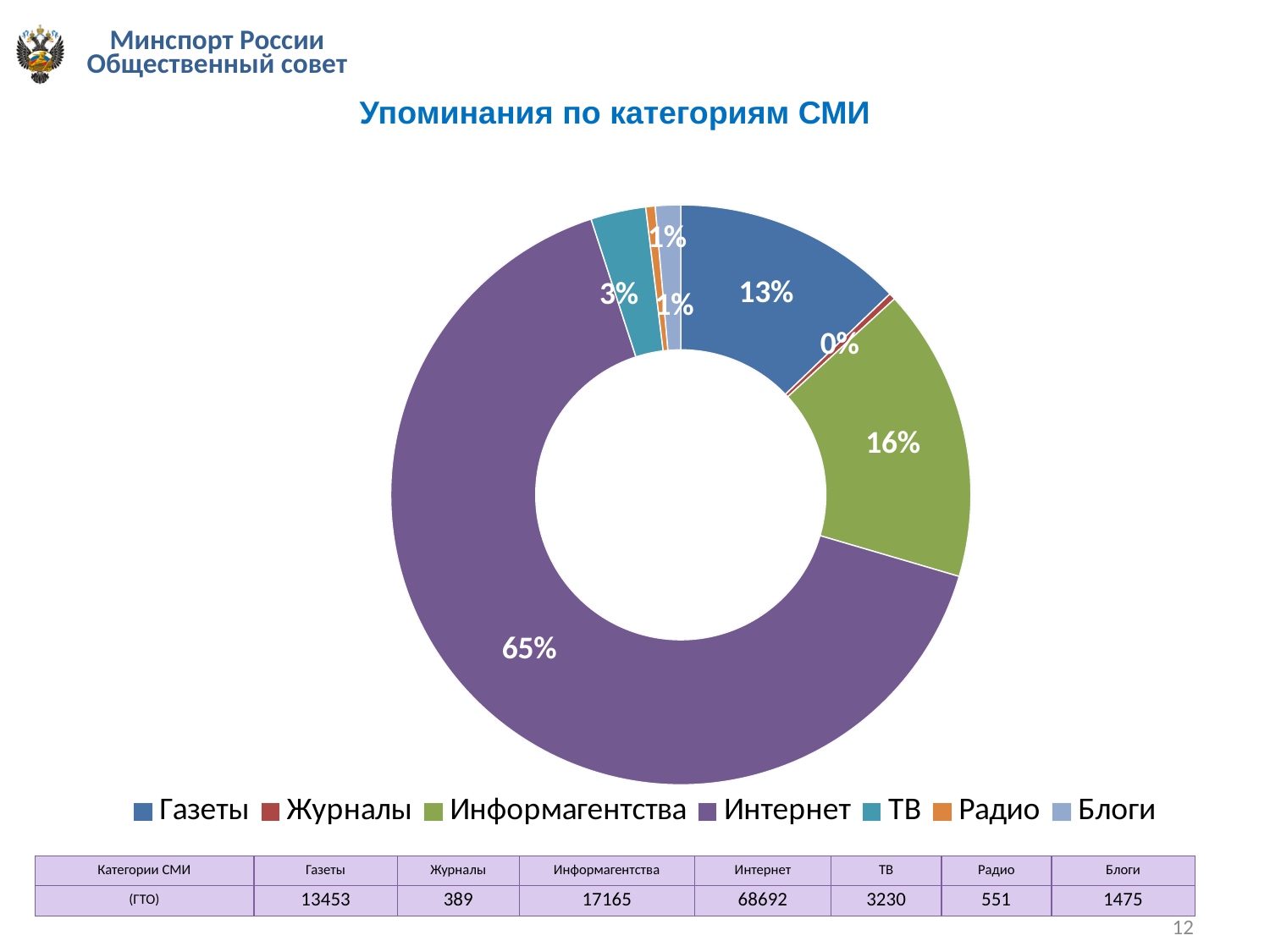
Which has a larger share, Газеты or Информагентства? Информагентства What percentage is shown for Информагентства? 16% What type of chart is shown on the slide? Doughnut (pie) chart What percentage is shown for ТВ? 3% What is the difference in percentage points between the shares of Интернет and Информагентства? 49 How many categories does the legend of the chart list? 7 What percentage is shown for Газеты? 13% What share of the chart does Интернет account for? 65% Which category has the largest share of the chart? Интернет What is the title of the chart? Упоминания по категориям СМИ Which category has the smallest share of the chart? Журналы According to the table below the chart, what is the number of mentions for Интернет? 68692